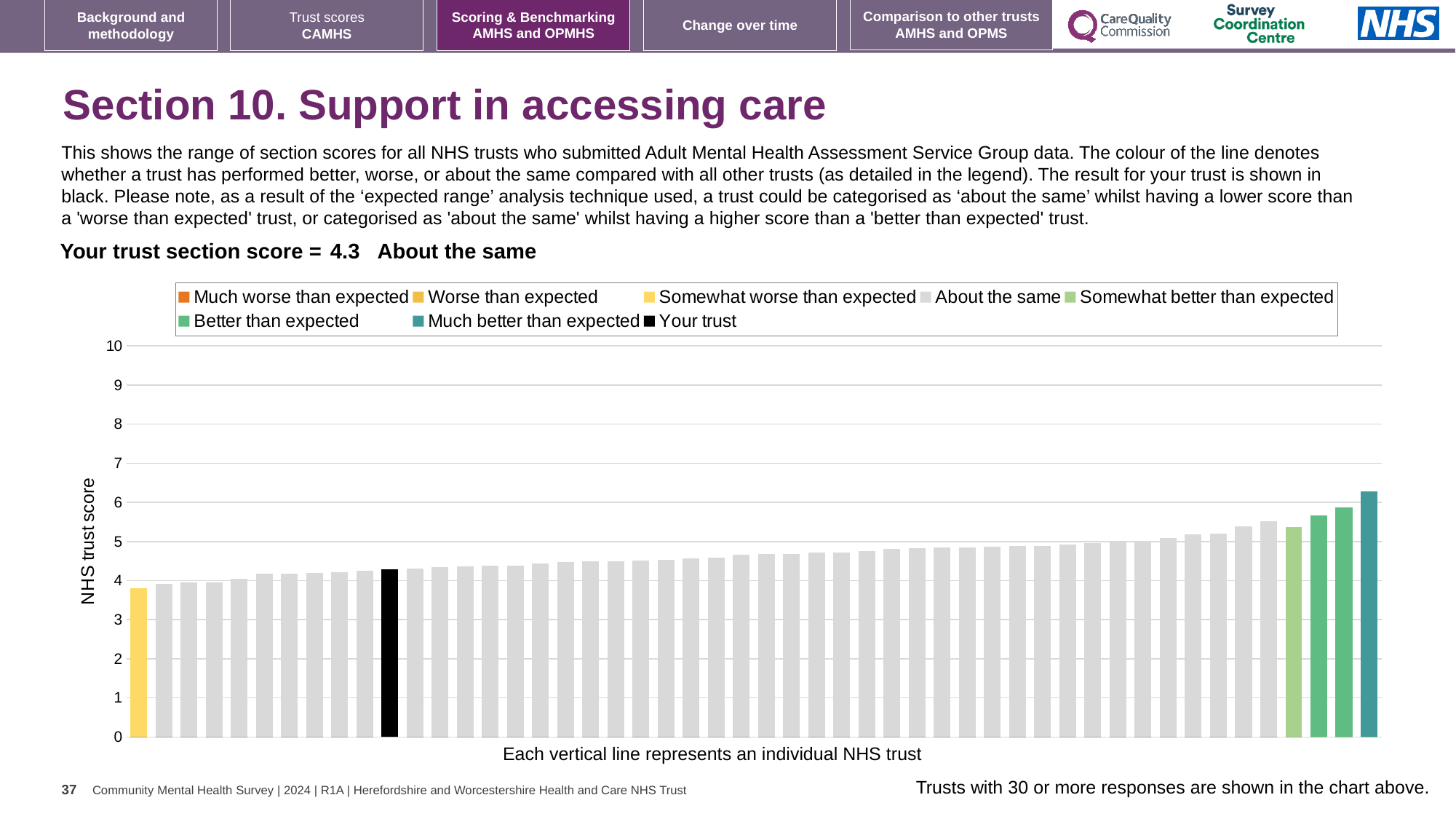
What is the section score for your trust? 4.3 Which is larger: the score for your trust or the score of the leftmost (yellow) bar? your trust What is the label on the vertical axis of the chart? NHS trust score Is the value of the shortest bar greater or less than 4? less What kind of chart is shown on the slide? bar chart How many bars are coloured as 'Better than expected'? 2 Which is larger: the score for your trust or the score of the tallest bar? the tallest bar Is the value of the tallest bar greater or less than 6? greater How many entries does the chart legend list? 8 How many bars are coloured as 'Much better than expected'? 1 Is the value for your trust greater or less than 5? less Do the bar values rise or fall from left to right along the x axis? rise